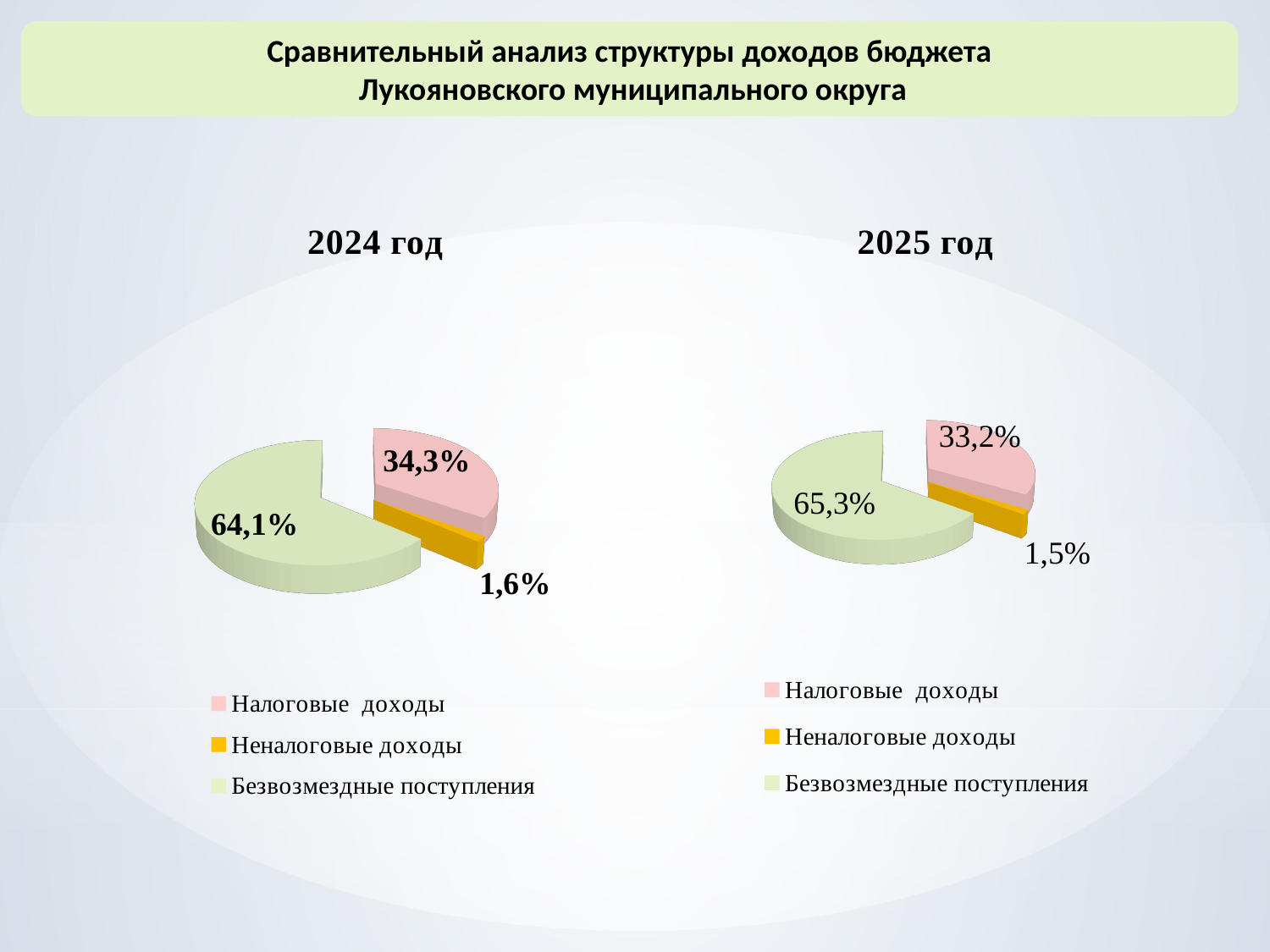
In the 2024 год chart, what colour is the slice for Неналоговые доходы? Orange (yellow-orange) In the 2024 год chart, which category has the largest slice? Безвозмездные поступления How many entries does the legend of the 2025 год chart list? 3 How many slices does the 2024 год pie chart have? 3 Which is larger: Налоговые доходы in the 2024 год chart or Налоговые доходы in the 2025 год chart? 2024 год (34,3%) In the 2025 год chart, what share do Налоговые доходы have? 33,2% In the 2025 год chart, which category has the smallest slice? Неналоговые доходы What is the difference between the share of Безвозмездные поступления in the 2025 год chart and in the 2024 год chart? 1,2% What type of chart is used for 2025 год? Pie chart In the 2025 год chart, what is the value for Неналоговые доходы? 1,5% In the 2024 год chart, what is the value for Неналоговые доходы? 1,6% In the 2024 год chart, what share do Безвозмездные поступления have? 64,1%